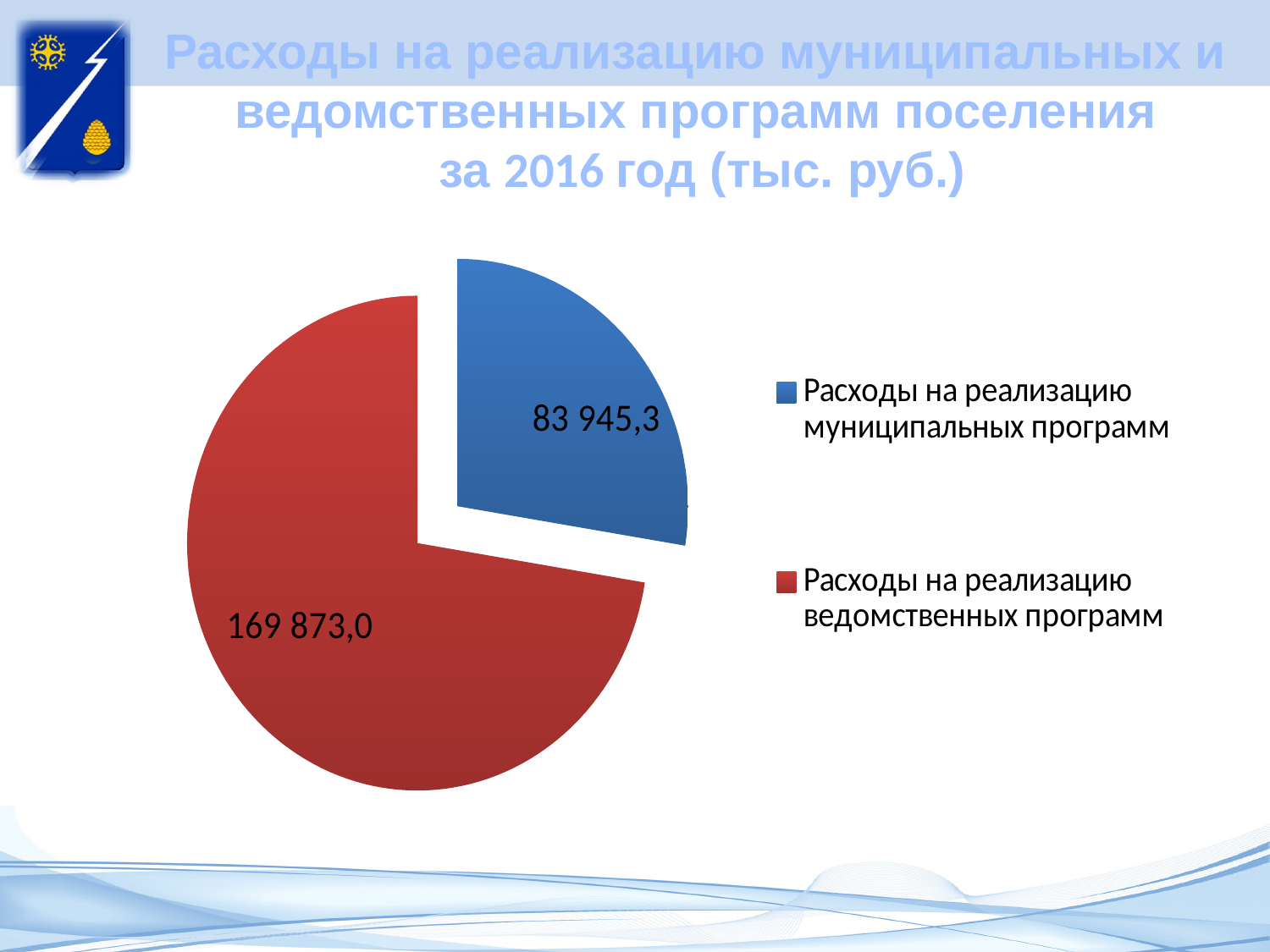
What is the difference between the value for ведомственных программ and the value for муниципальных программ? 85 927,7 What is the total of the two slices in the pie chart? 253 818,3 How many slices does the pie chart have? 2 What type of chart is shown on the slide? pie chart In what units are the values in the chart expressed, according to the slide title? тыс. руб. How many entries does the legend list? 2 Which is larger: the value for муниципальных программ or the value for ведомственных программ? Расходы на реализацию ведомственных программ What colour is the slice for Расходы на реализацию ведомственных программ? red What is the value for Расходы на реализацию ведомственных программ? 169 873,0 Which category has the largest slice of the pie? Расходы на реализацию ведомственных программ Which category has the smallest slice of the pie? Расходы на реализацию муниципальных программ What is the value for Расходы на реализацию муниципальных программ? 83 945,3